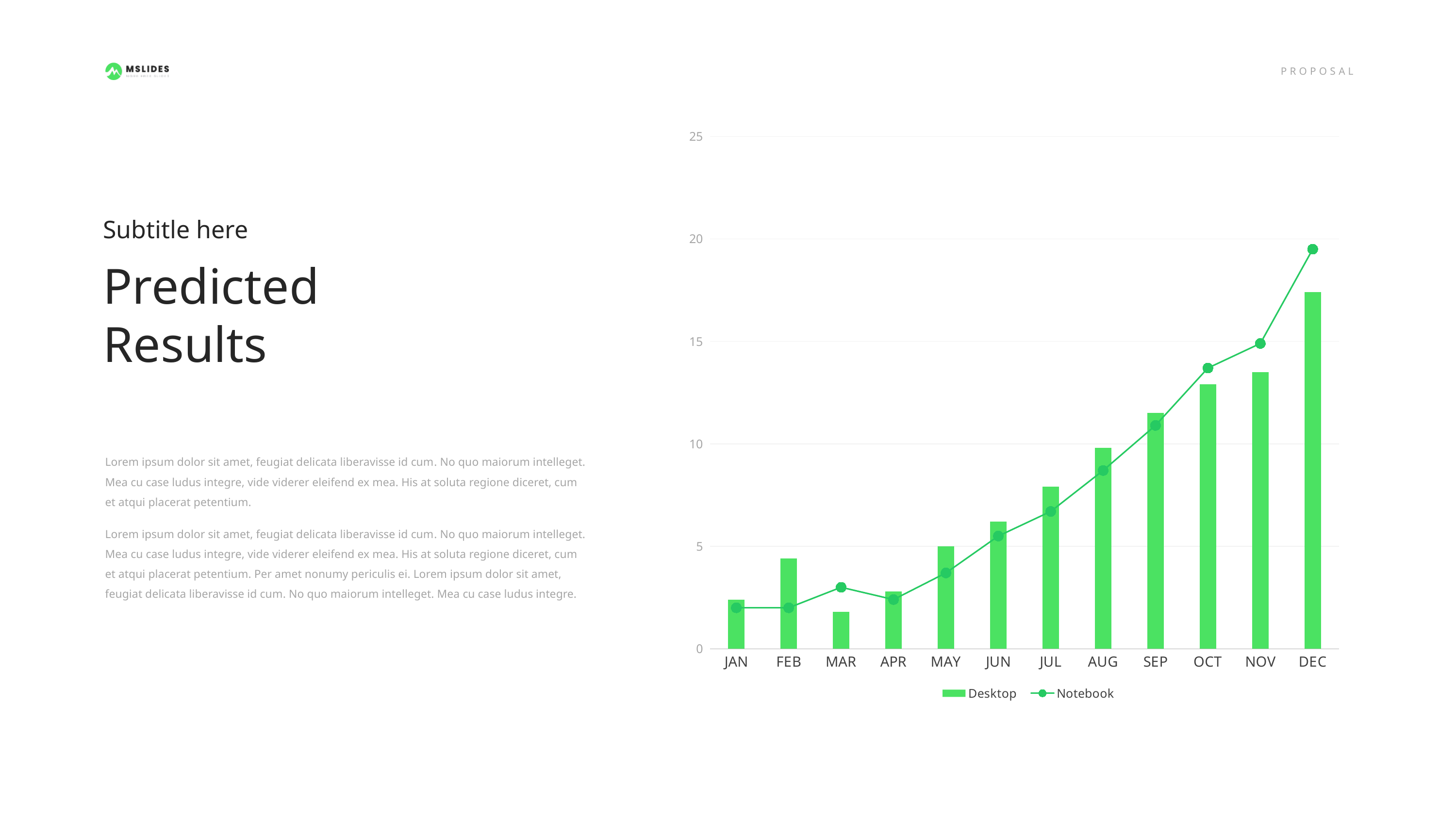
Is the Desktop value for MAR greater or less than 5? less How many months are shown on the x axis? 12 In DEC, which is larger, the Desktop value or the Notebook value? Notebook Which month has the lowest Desktop bar? MAR Overall, do the Notebook values rise or fall from JAN to DEC? rise In FEB, which is larger, the Desktop value or the Notebook value? Desktop Is the Desktop value for DEC greater or less than 15? greater Which month has the highest Desktop bar? DEC How many series does the legend list? 2 What kind of chart is shown on the slide? A combined bar and line chart Which month has the highest Notebook value? DEC Is the Notebook value for OCT greater or less than 10? greater